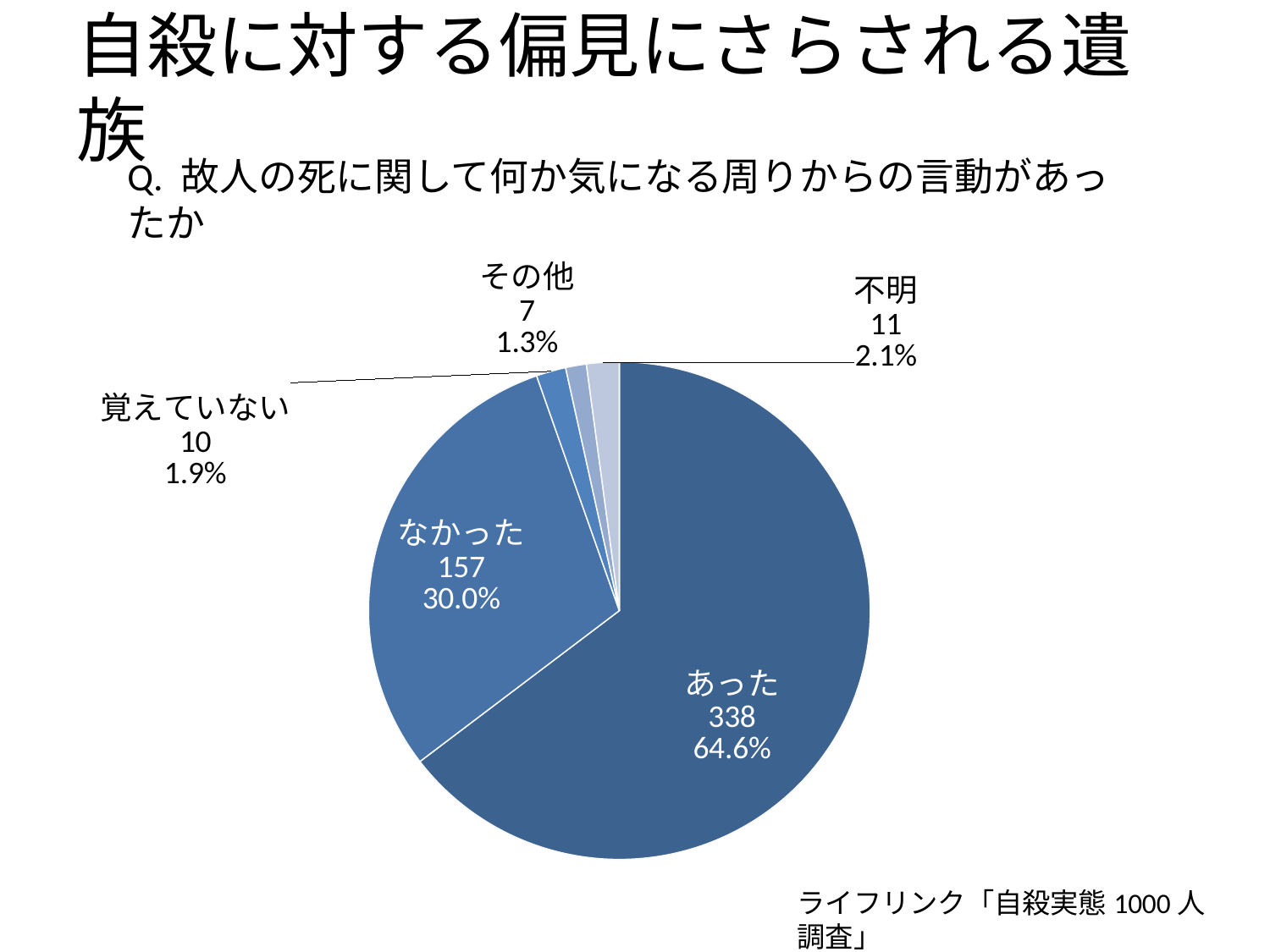
Which is larger, the count for 不明 or the count for 覚えていない? 不明 What is the difference in count between あった and なかった? 181 Which category has the largest slice? あった What percentage does the なかった slice represent? 30.0% What is the count for the その他 slice? 7 What share of the pie does the あった slice represent? 64.6% What is the count for the 不明 slice? 11 What percentage does the 覚えていない slice represent? 1.9% What kind of chart is shown on the slide? pie chart Which category has the smallest slice? その他 How many slices does the pie chart have? 5 What is the count for the あった slice? 338